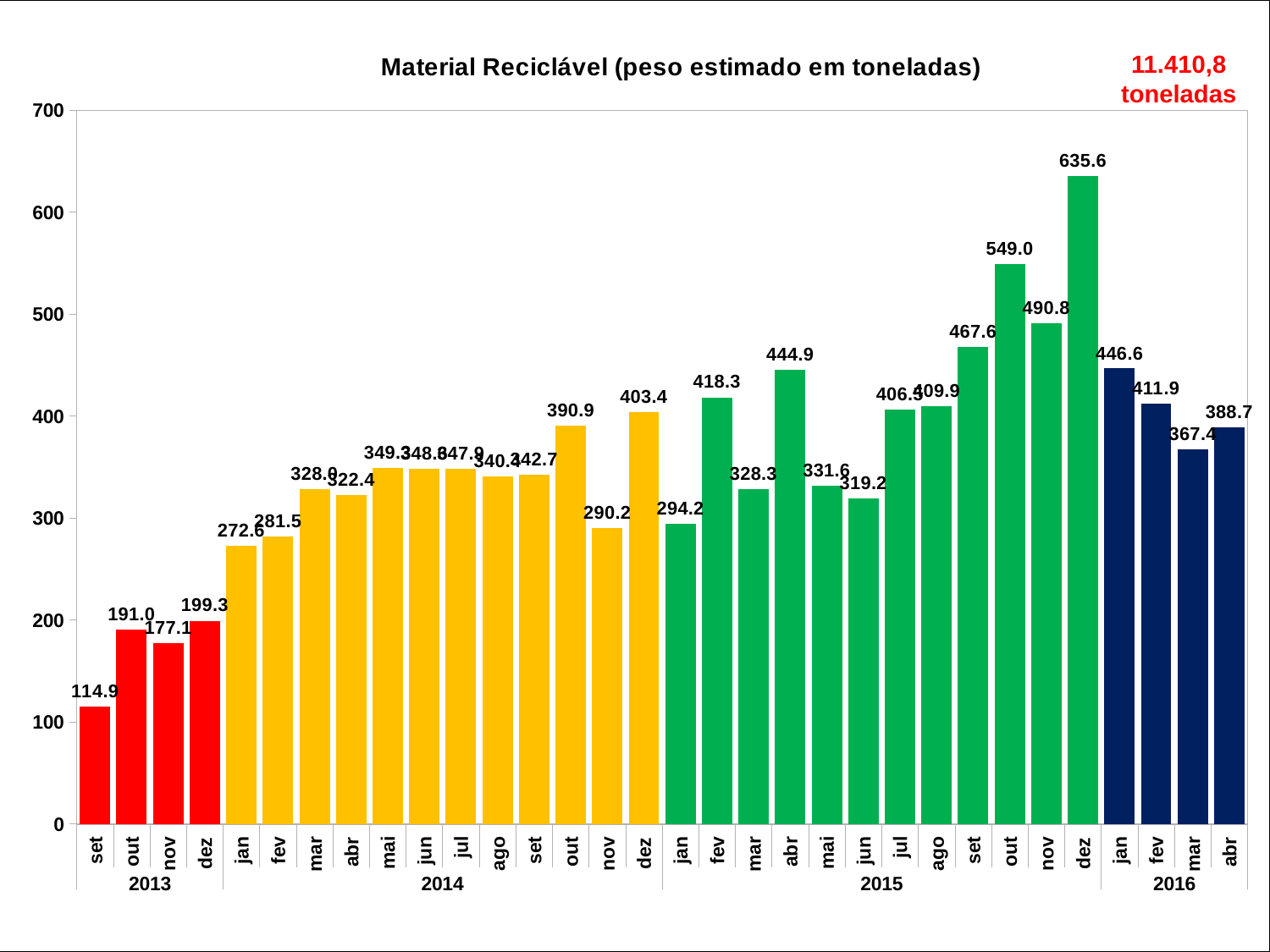
What is the difference between the values for out 2015 and nov 2015? 58.2 Is the value for nov 2014 greater or less than 300? less What is the value for dez 2015? 635.6 What kind of chart is shown on the slide? bar chart How many monthly bars are plotted in the chart? 32 What is the value for set 2013? 114.9 What is the value for abr 2016? 388.7 Which month has the lowest value? set 2013 Do the values rise or fall from jan 2016 to mar 2016? fall What is the difference between the highest value (dez 2015) and the lowest value (set 2013)? 520.7 Which month has the highest value? dez 2015 Which is larger, the value for out 2014 or the value for dez 2014? dez 2014